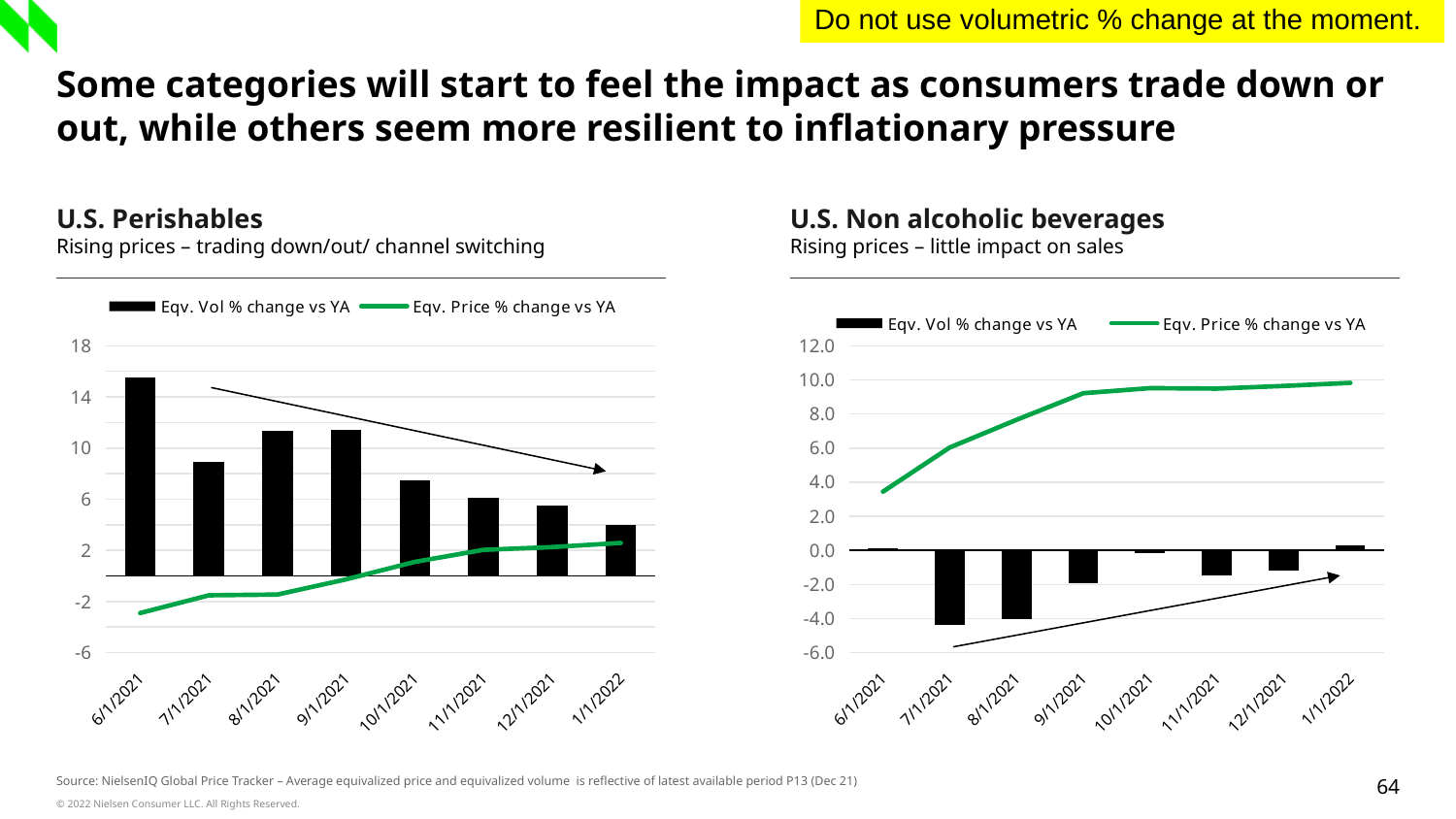
How many dates are shown on the x axis of the U.S. Perishables chart? 8 In the U.S. Perishables chart, which is larger, the Eqv. Vol % change vs YA bar for 7/1/2021 or for 8/1/2021? 8/1/2021 How many series does the legend of the U.S. Non alcoholic beverages chart list? 2 In the U.S. Perishables chart, which date has the lowest Eqv. Vol % change vs YA bar? 1/1/2022 What kind of chart is the U.S. Non alcoholic beverages chart? Combined bar and line chart In the U.S. Perishables chart, which date has the highest Eqv. Vol % change vs YA bar? 6/1/2021 In the U.S. Perishables chart, does the Eqv. Price % change vs YA line rise or fall from 6/1/2021 to 1/1/2022? rise In the U.S. Perishables chart, is the Eqv. Vol % change vs YA value for 1/1/2022 greater or less than 6? less In the U.S. Non alcoholic beverages chart, is the Eqv. Price % change vs YA value for 6/1/2021 greater or less than 4.0? less In the U.S. Non alcoholic beverages chart, is the Eqv. Price % change vs YA value for 1/1/2022 greater or less than 8.0? greater In the U.S. Non alcoholic beverages chart, which date has the lowest Eqv. Vol % change vs YA bar? 7/1/2021